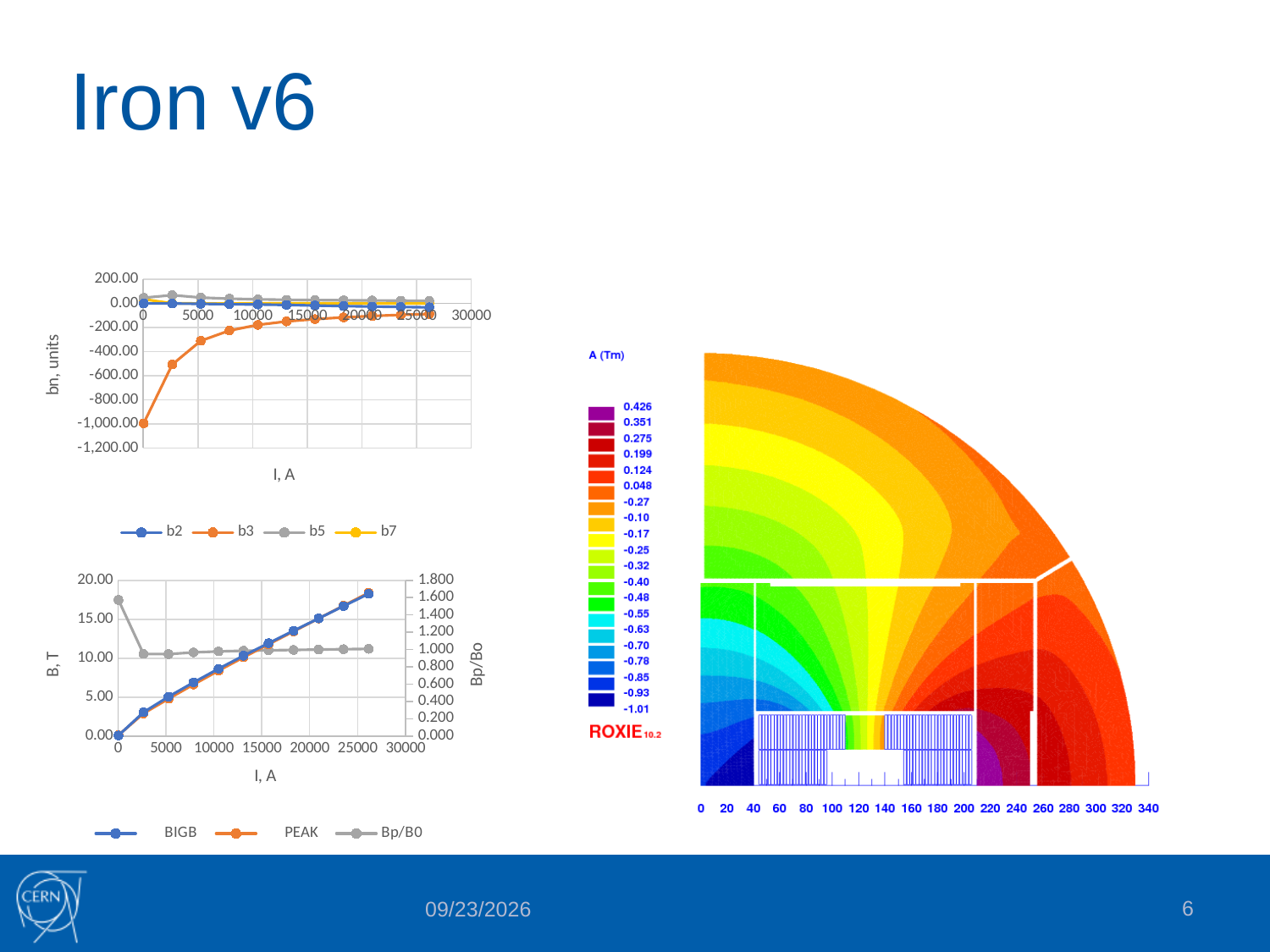
What kind of chart is the top-left chart with y-axis 'bn, units'? line chart In the top-left chart (bn, units), which series has the lowest value at I = 0? b3 In the bottom-left chart, is the Bp/B0 value at I = 0 greater or less than 1.400 on the right axis? greater In the bottom-left chart (B, T), is the BIGB value at the highest current (about 26000 A) greater or less than 15.00? greater What is the x-axis title of the top-left chart? I, A In the bottom-left chart, is the Bp/B0 value at I = 15000 greater or less than 1.200 on the right axis? less In the top-left chart (bn, units), does the b3 series rise or fall as I increases? rise In the bottom-left chart (B, T), does the BIGB series rise or fall as I increases? rise How many series does the legend of the top-left chart (bn, units) list? 4 What is the title of the right-hand y-axis of the bottom-left chart? Bp/Bo How many series does the legend of the bottom-left chart (B, T) list? 3